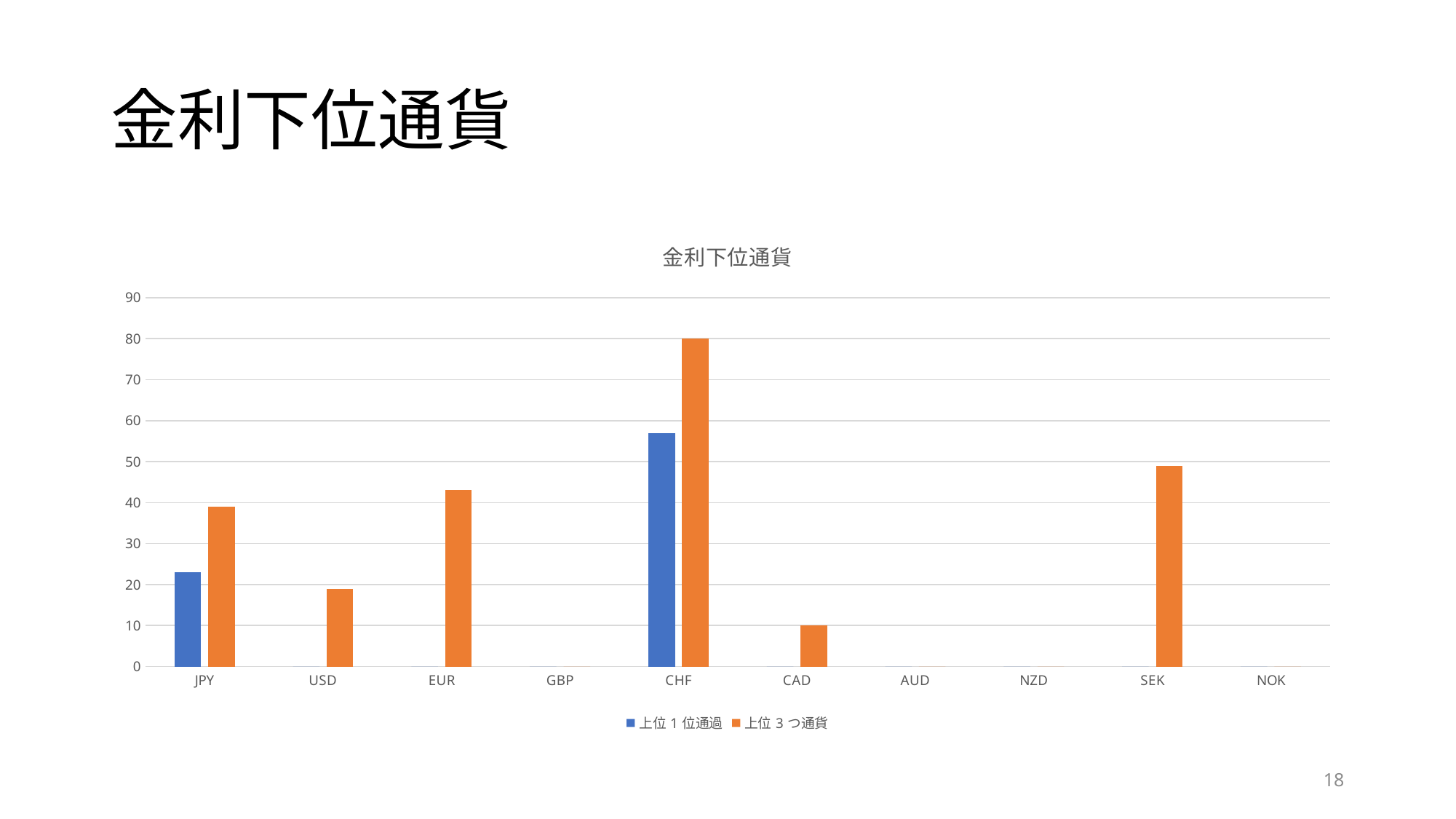
Which currency has the highest value for the 上位 3 つ通貨 series? CHF Which currency has the highest value for the 上位 1 位通過 series? CHF What is the value for CHF in the 上位 3 つ通貨 series? 80 Is the value for USD in the 上位 3 つ通貨 series greater or less than 30? less What kind of chart is shown on the slide? bar chart What is the title of the chart? 金利下位通貨 What is the value for CAD in the 上位 3 つ通貨 series? 10 For JPY, which series has the larger value, 上位 1 位通過 or 上位 3 つ通貨? 上位 3 つ通貨 How many currency categories are shown on the x axis? 10 How many series does the legend list? 2 Is the value for JPY in the 上位 3 つ通貨 series greater or less than 30? greater Is the value for CHF in the 上位 1 位通過 series greater or less than 50? greater